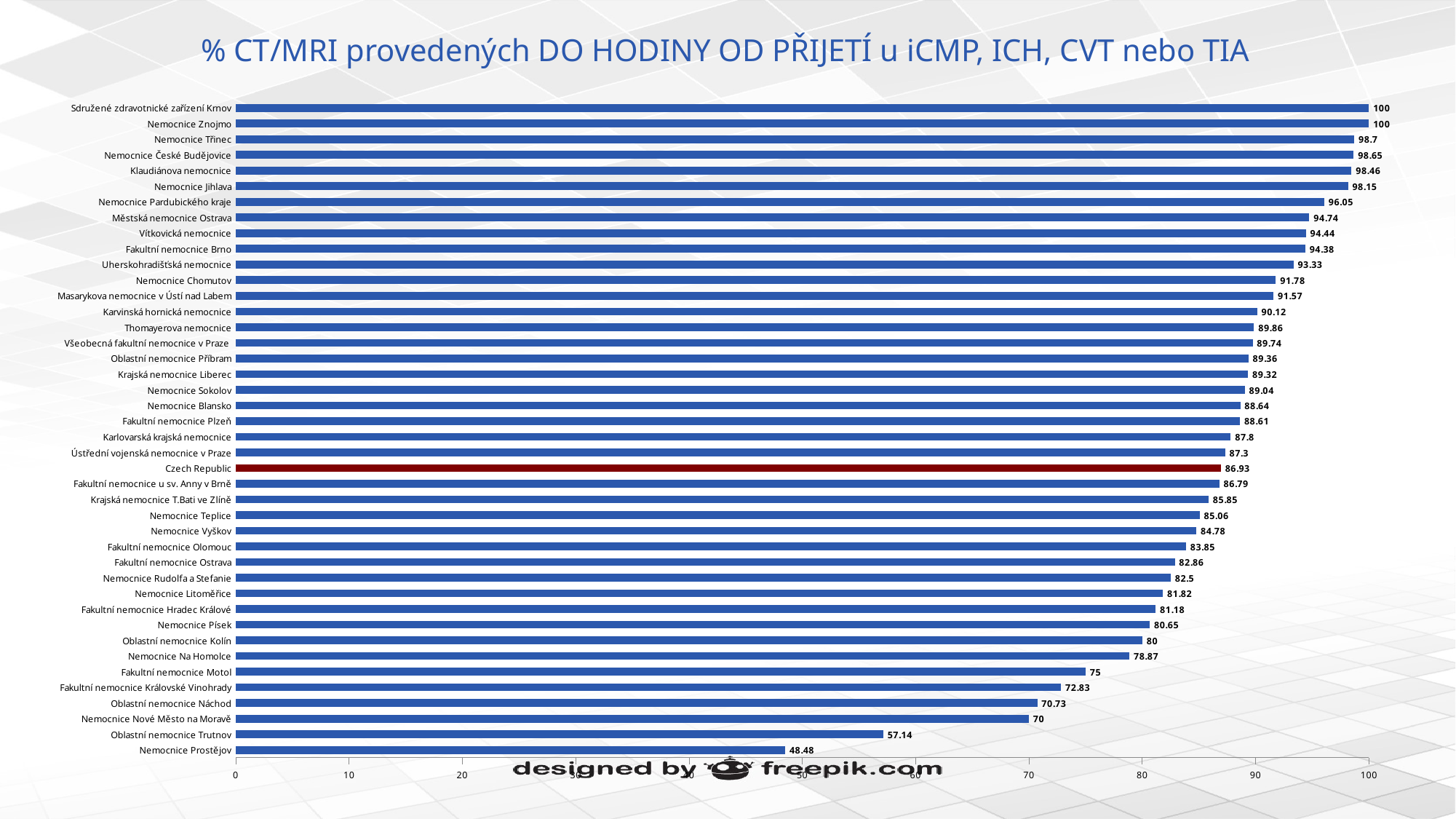
What is the difference between the values for Nemocnice Třinec and Nemocnice Prostějov? 50.22 What kind of chart is shown on the slide? bar chart Which is larger, the value for Fakultní nemocnice Brno or the value for Fakultní nemocnice Ostrava? Fakultní nemocnice Brno What is the value for Fakultní nemocnice Motol? 75 What is the value for Oblastní nemocnice Trutnov? 57.14 Which category's bar is coloured dark red instead of blue? Czech Republic Which category has the lowest value? Nemocnice Prostějov Is the value for Oblastní nemocnice Náchod greater or less than 80? less What is the value for Nemocnice Jihlava? 98.15 How many categories are shown on the chart? 42 What is the value for Czech Republic? 86.93 What is the difference between the values for Czech Republic and Fakultní nemocnice Motol? 11.93